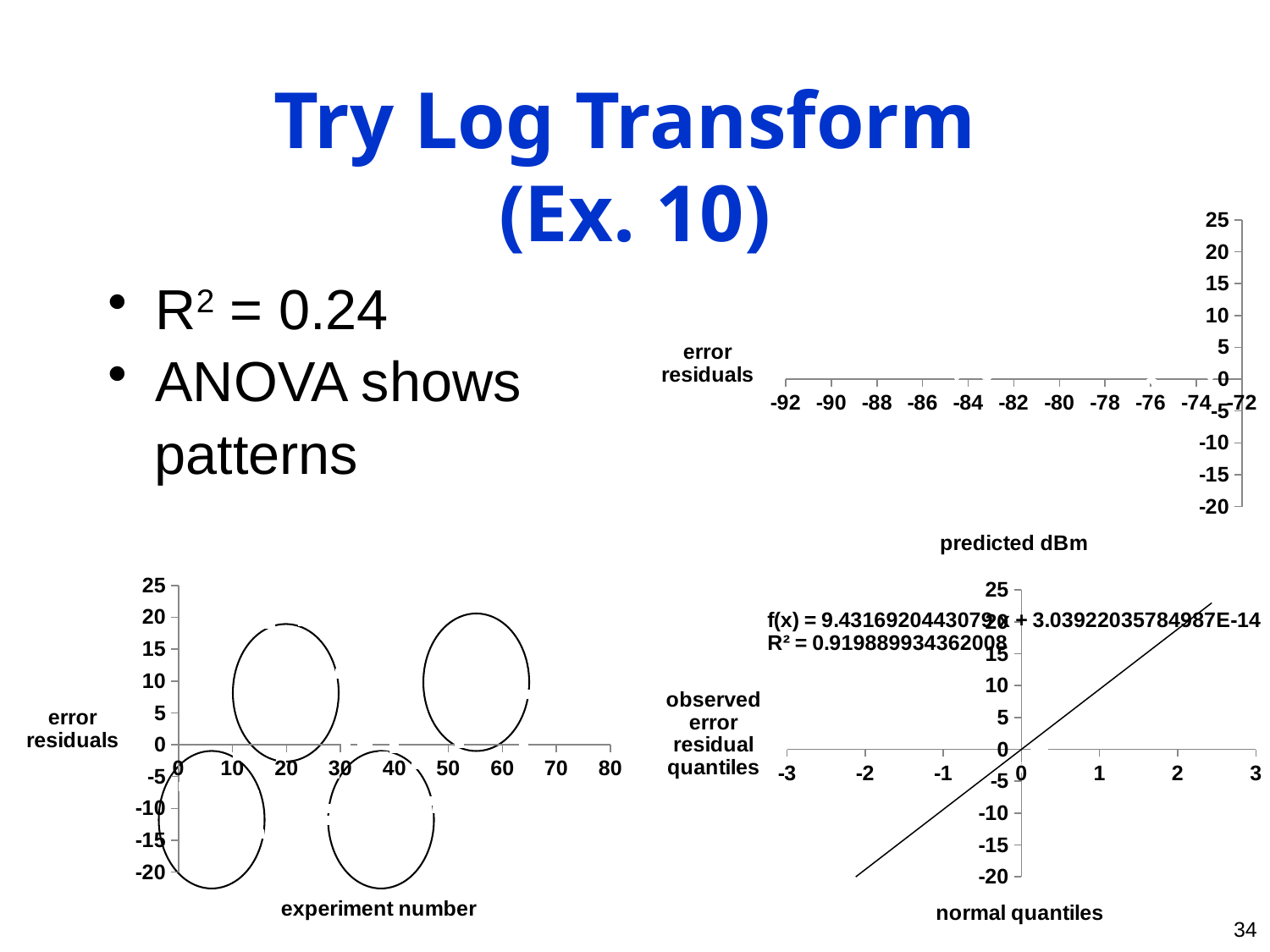
In the bottom-right chart, does the fitted line rise or fall as the normal quantiles increase? rise In the bottom-right chart, what is the slope coefficient of x in the printed equation f(x)? 9.43169204430796 How many charts are shown on the slide? 3 What is the x-axis label of the bottom-left chart? experiment number What kind of chart is the bottom-right chart (observed error residual quantiles vs normal quantiles)? scatter chart In the bottom-right chart, what is the intercept term in the printed equation f(x)? 3.03922035784987E-14 In the bottom-right chart, what R² value is printed for the fitted line? 0.919889934362008 What kind of chart is the bottom-left chart (error residuals vs experiment number)? scatter chart